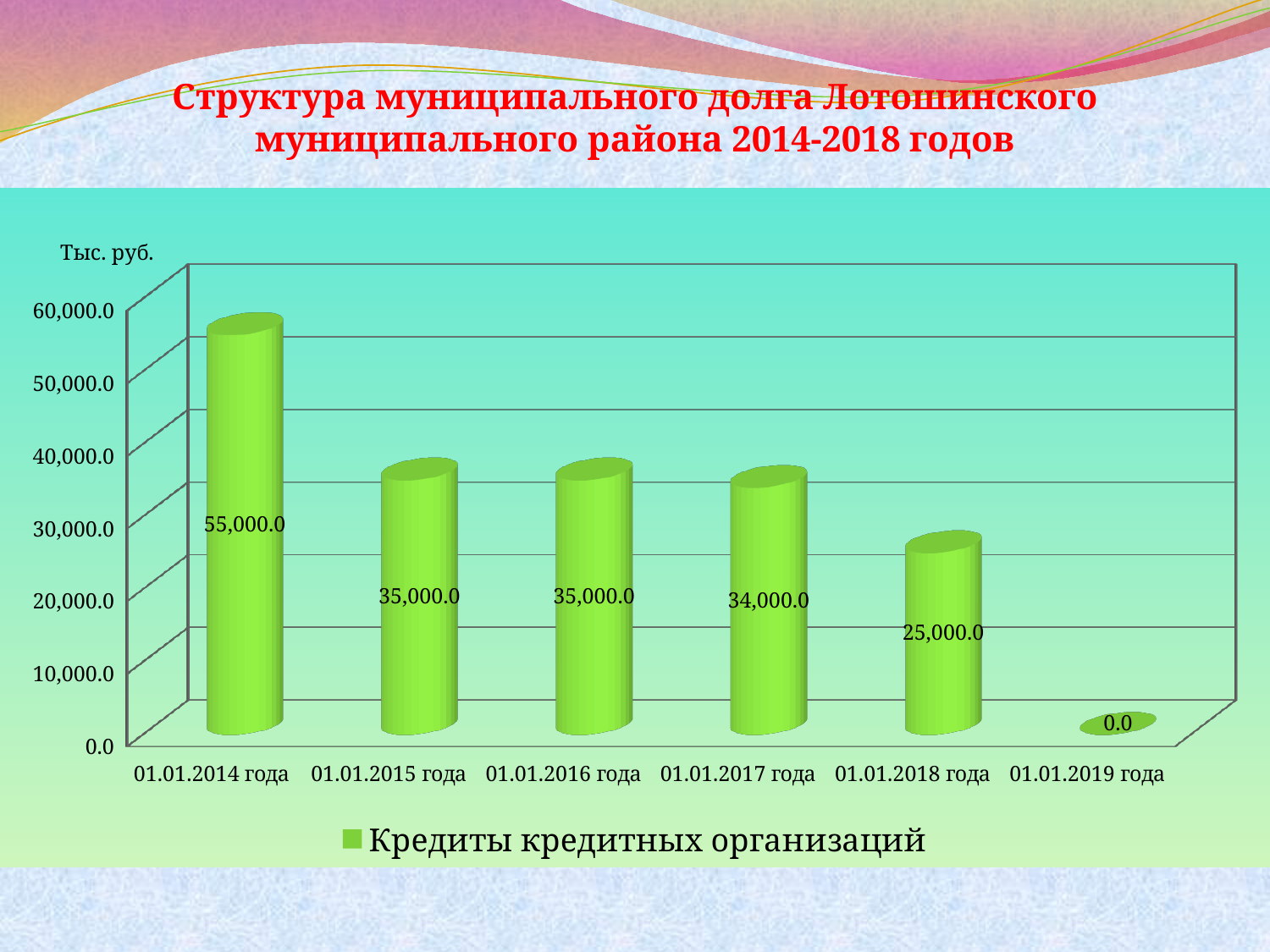
What is the value for 01.01.2017 года? 34,000.0 What is the value for 01.01.2014 года? 55,000.0 Which is larger, the value for 01.01.2017 года or the value for 01.01.2018 года? 01.01.2017 года How many series does the legend list? 1 Do the values rise or fall from 01.01.2014 года to 01.01.2019 года? fall What is the difference between the values for 01.01.2014 года and 01.01.2015 года? 20,000.0 What is the value for 01.01.2018 года? 25,000.0 Which category has the lowest value? 01.01.2019 года What kind of chart is shown on the slide? bar chart How many categories are shown on the x axis? 6 Which category has the highest value? 01.01.2014 года What is the value for 01.01.2019 года? 0.0